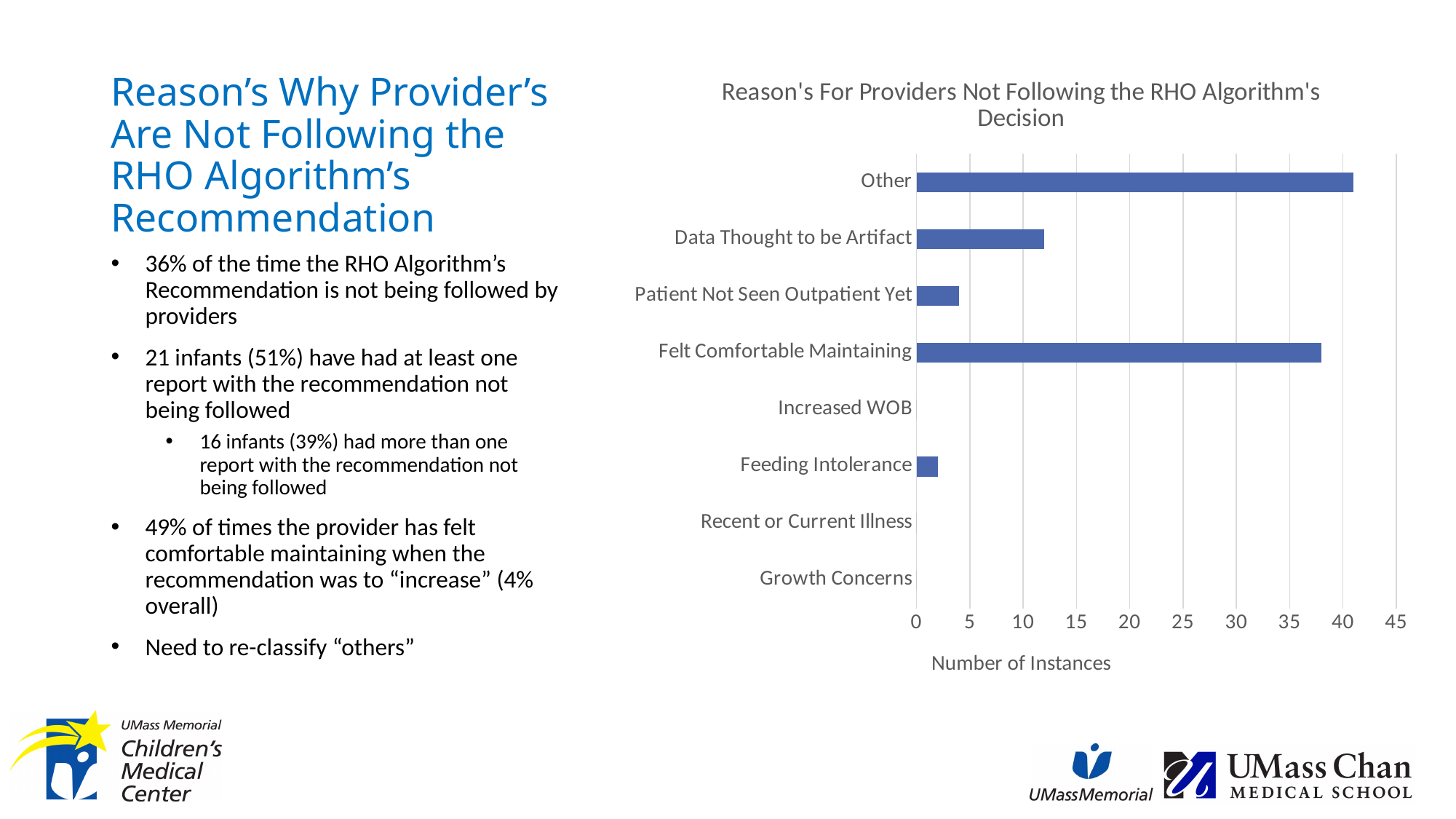
Is the value for Data Thought to be Artifact greater or less than 10? greater Is the value for Patient Not Seen Outpatient Yet greater or less than 5? less What is the title of the chart? Reason's For Providers Not Following the RHO Algorithm's Decision What kind of chart is shown on the slide? bar chart Is the value for Feeding Intolerance greater or less than 5? less Which has more instances, Felt Comfortable Maintaining or Data Thought to be Artifact? Felt Comfortable Maintaining What is the label of the horizontal axis of the chart? Number of Instances Which has more instances, Data Thought to be Artifact or Patient Not Seen Outpatient Yet? Data Thought to be Artifact How many categories are listed on the vertical axis of the chart? 8 Which category has the highest number of instances? Other